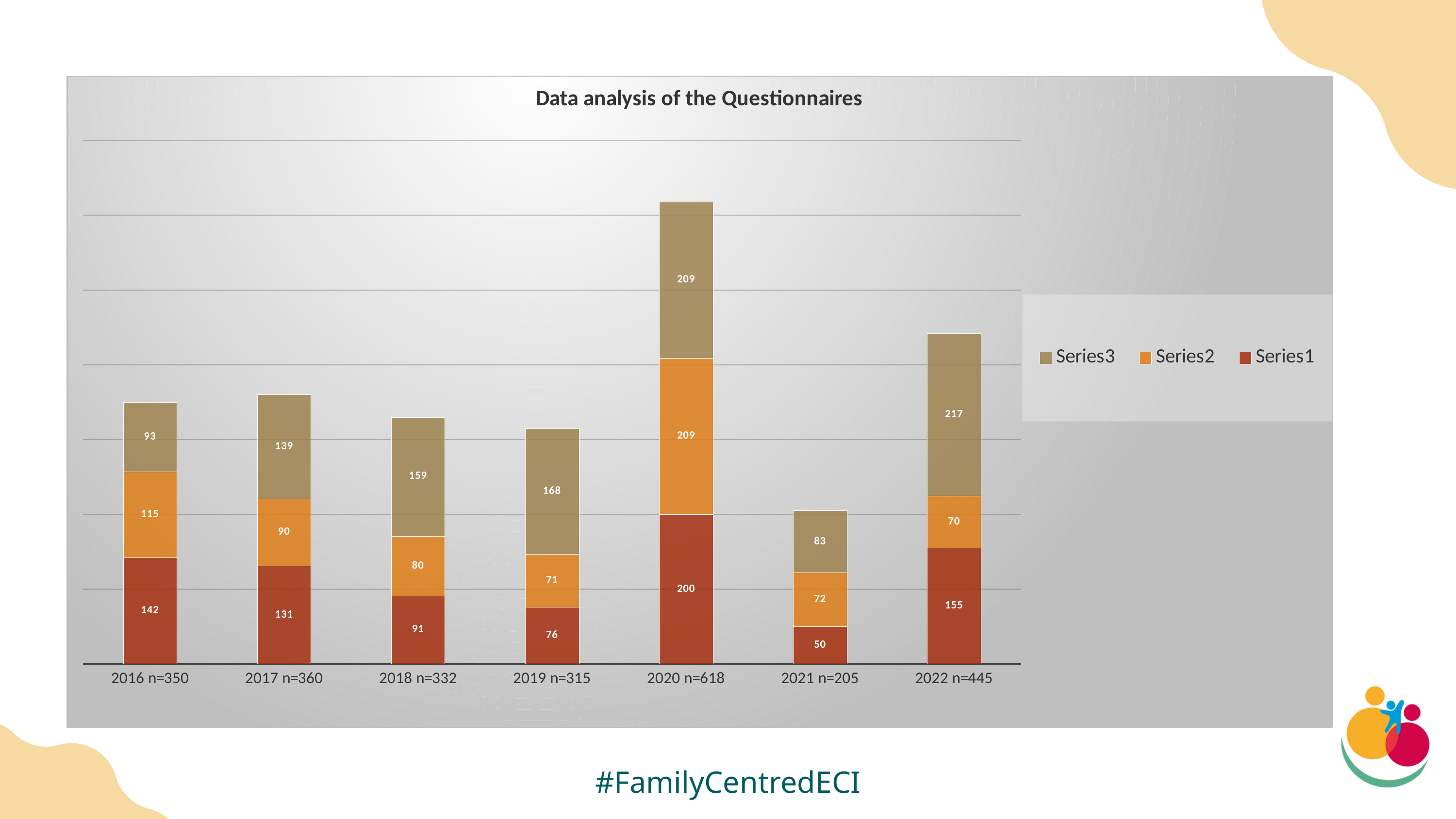
What is the total of the stacked bar for 2016 n=350? 350 Which category has the lowest Series1 value? 2021 n=205 How many series does the legend list? 3 What is the value of Series1 for 2020 n=618? 200 How many categories are shown on the x axis? 7 What is the title of the chart? Data analysis of the Questionnaires What kind of chart is shown on the slide? Stacked bar chart What is the difference between the Series3 value for 2020 n=618 and the Series3 value for 2016 n=350? 116 What is the value of Series2 for 2021 n=205? 72 Which category has the highest Series1 value? 2020 n=618 Which has the larger Series2 value, 2016 n=350 or 2017 n=360? 2016 n=350 What is the value of Series3 for 2022 n=445? 217